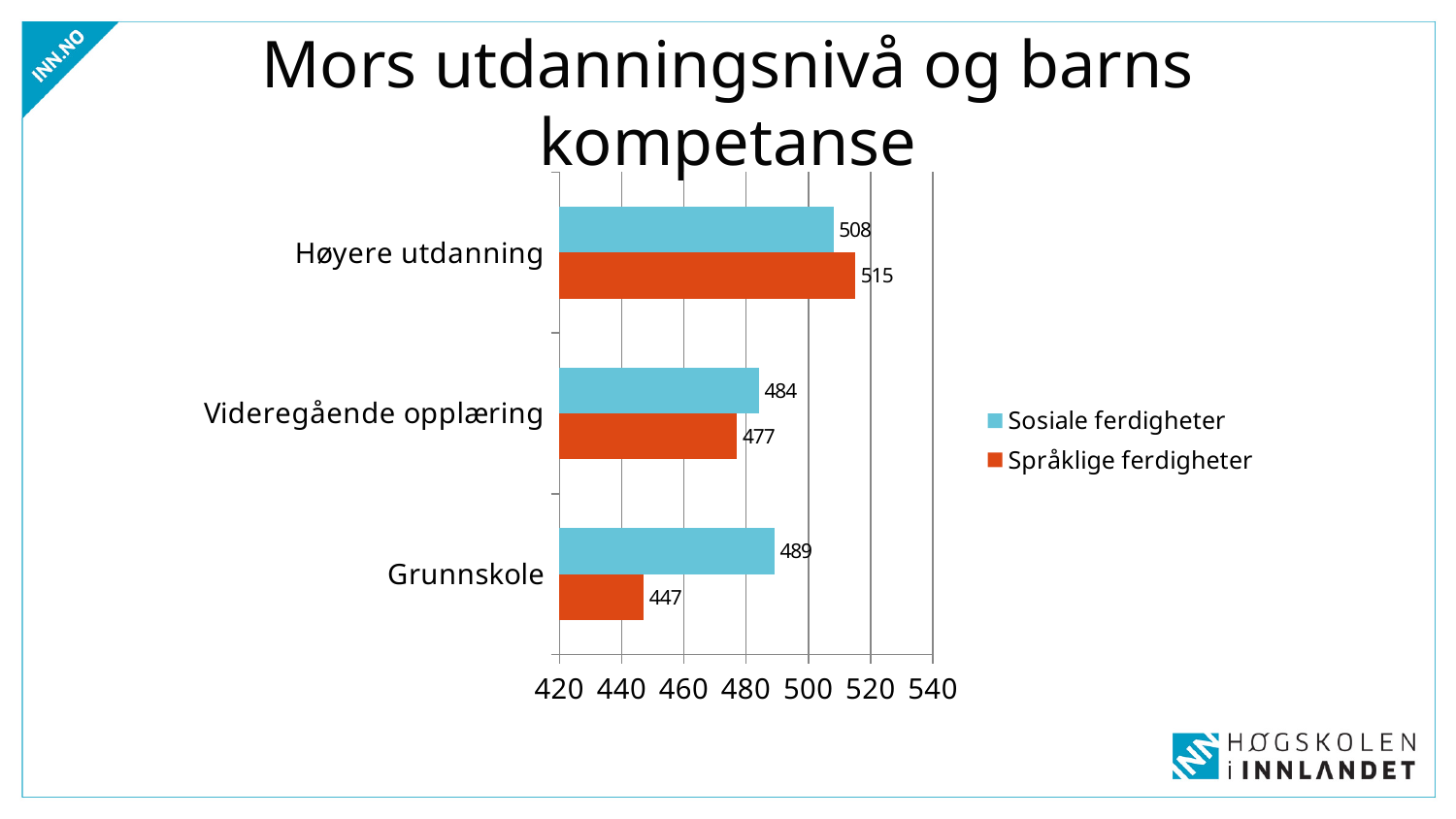
What is the title of the slide? Mors utdanningsnivå og barns kompetanse How many categories are shown on the chart? 3 What is the difference between Sosiale ferdigheter and Språklige ferdigheter for Grunnskole? 42 What is the value of Språklige ferdigheter for Grunnskole? 447 What is the value of Sosiale ferdigheter for Høyere utdanning? 508 Is the value of Språklige ferdigheter for Grunnskole greater or less than 460? less How many series does the legend list? 2 Which is larger for Høyere utdanning: Sosiale ferdigheter or Språklige ferdigheter? Språklige ferdigheter Which category has the highest value for Språklige ferdigheter? Høyere utdanning Which category has the lowest value for Sosiale ferdigheter? Videregående opplæring What is the value of Språklige ferdigheter for Videregående opplæring? 477 What kind of chart is shown on the slide? Bar chart